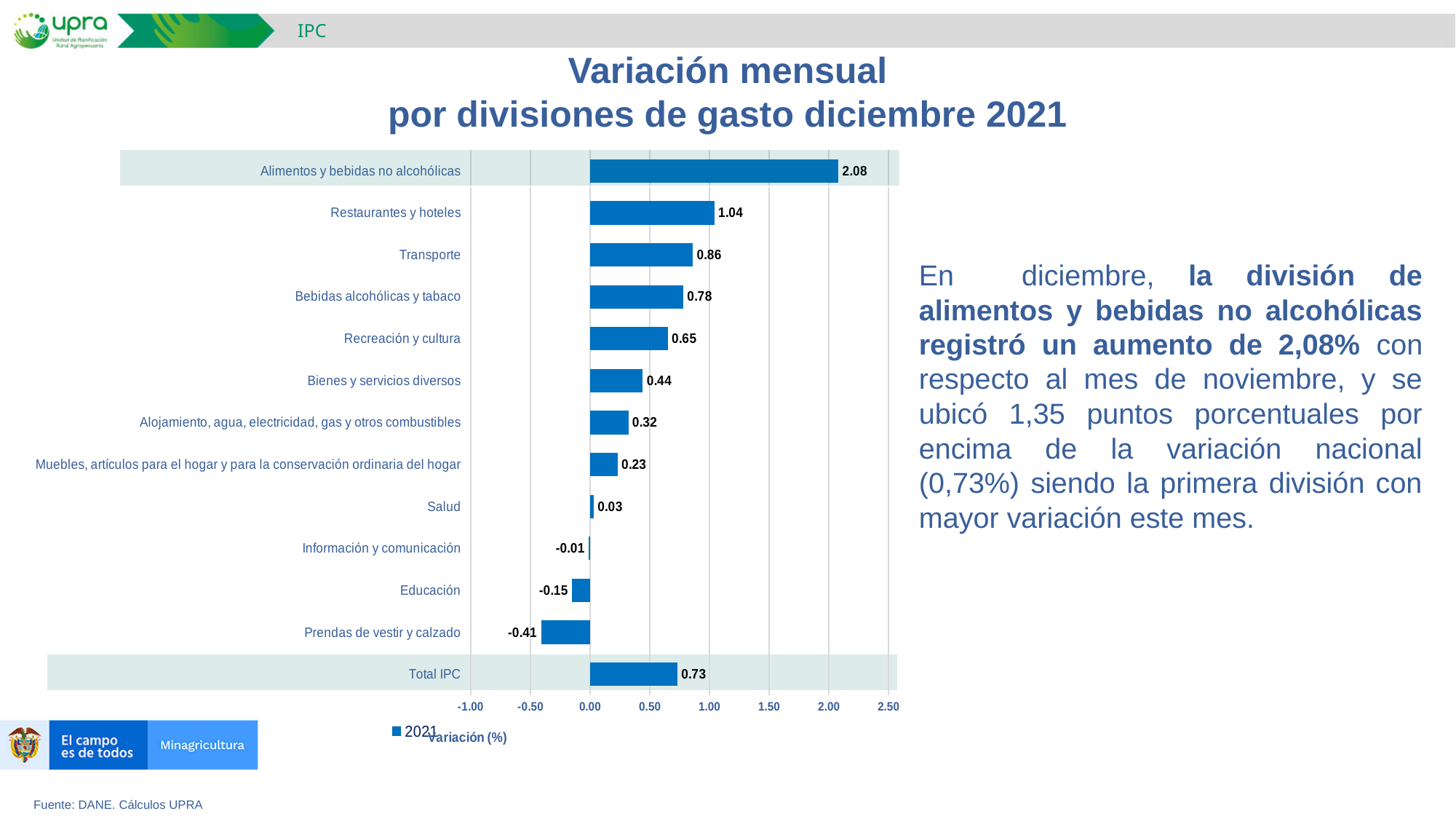
What is the value for Alimentos y bebidas no alcohólicas? 2.08 Which is larger, the value for Recreación y cultura or the value for Bienes y servicios diversos? Recreación y cultura Which category has the highest value? Alimentos y bebidas no alcohólicas What is the difference between the values for Restaurantes y hoteles and Transporte? 0.18 What is the value for Total IPC? 0.73 Is the value for Restaurantes y hoteles greater or less than 1.00? greater What is the value for Prendas de vestir y calzado? -0.41 Which category has the lowest value? Prendas de vestir y calzado What is the value for Transporte? 0.86 How many categories are shown on the chart? 13 What kind of chart is shown on the slide? bar chart What is the label on the horizontal axis of the chart? Variación (%)